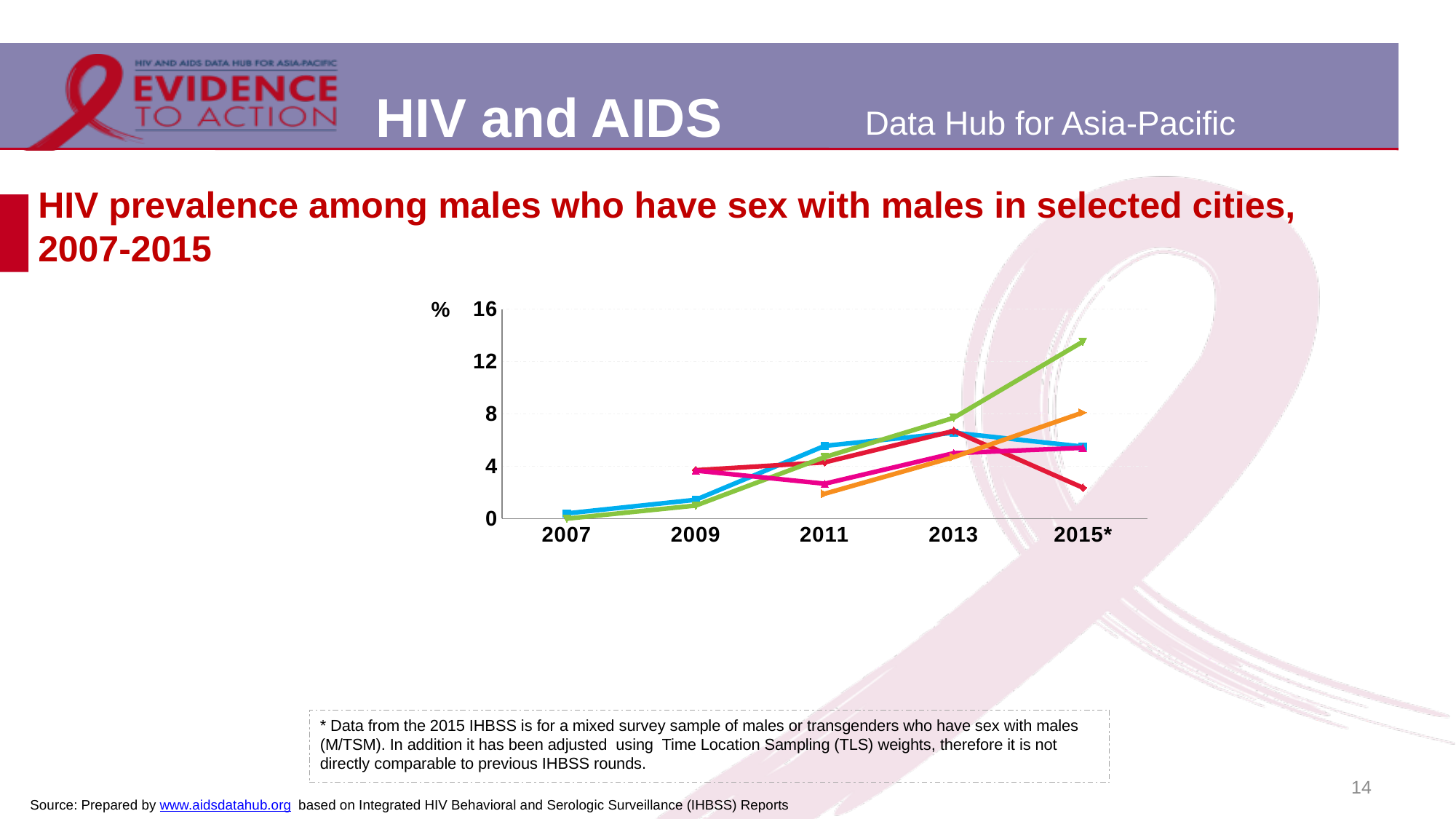
How many years are shown on the x axis of the chart? 5 In 2015*, which is higher, the green line or the orange line? the green line Is the value of the blue line in 2007 greater or less than 4? less Is the value of the red line in 2015* greater or less than 4? less What unit is shown on the y axis of the chart? % What is the title of the chart on the slide? HIV prevalence among males who have sex with males in selected cities, 2007-2015 Is the value of the orange line in 2011 greater or less than 4? less What kind of chart is shown on the slide? line chart Which line has the lowest value in 2015*? the red line Does the green line rise or fall from 2007 to 2015*? rises Which line has the highest value in 2015*? the green line